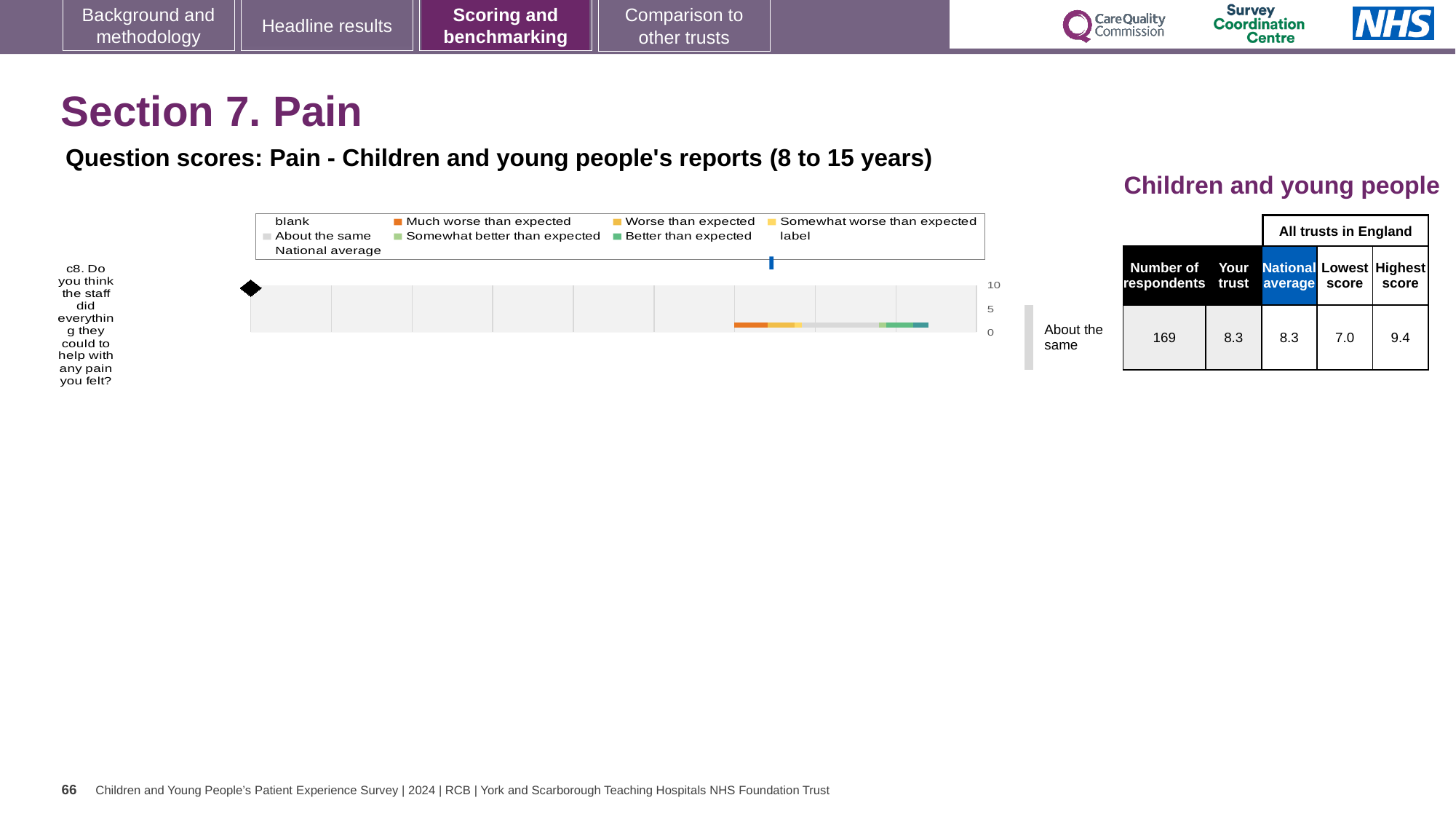
According to the table beside the chart, what is the 'Your trust' score for question c8? 8.3 What is the difference between the highest score and the 'Your trust' score shown in the table for question c8? 1.1 How many questions (categories) are plotted in the chart? 1 Which question is plotted in the chart? c8. Do you think the staff did everything they could to help with any pain you felt? According to the table beside the chart, what is the highest score among all trusts in England for question c8? 9.4 What benchmark category is the trust's result for question c8 labelled as next to the chart? About the same What is the highest value shown on the chart's score axis? 10 According to the table beside the chart, what is the lowest score among all trusts in England for question c8? 7.0 What is the difference between the highest score and the lowest score shown in the table for question c8? 2.4 According to the table beside the chart, how many respondents answered question c8? 169 What kind of chart is shown on the slide? Bar chart According to the table beside the chart, what is the national average score for question c8? 8.3